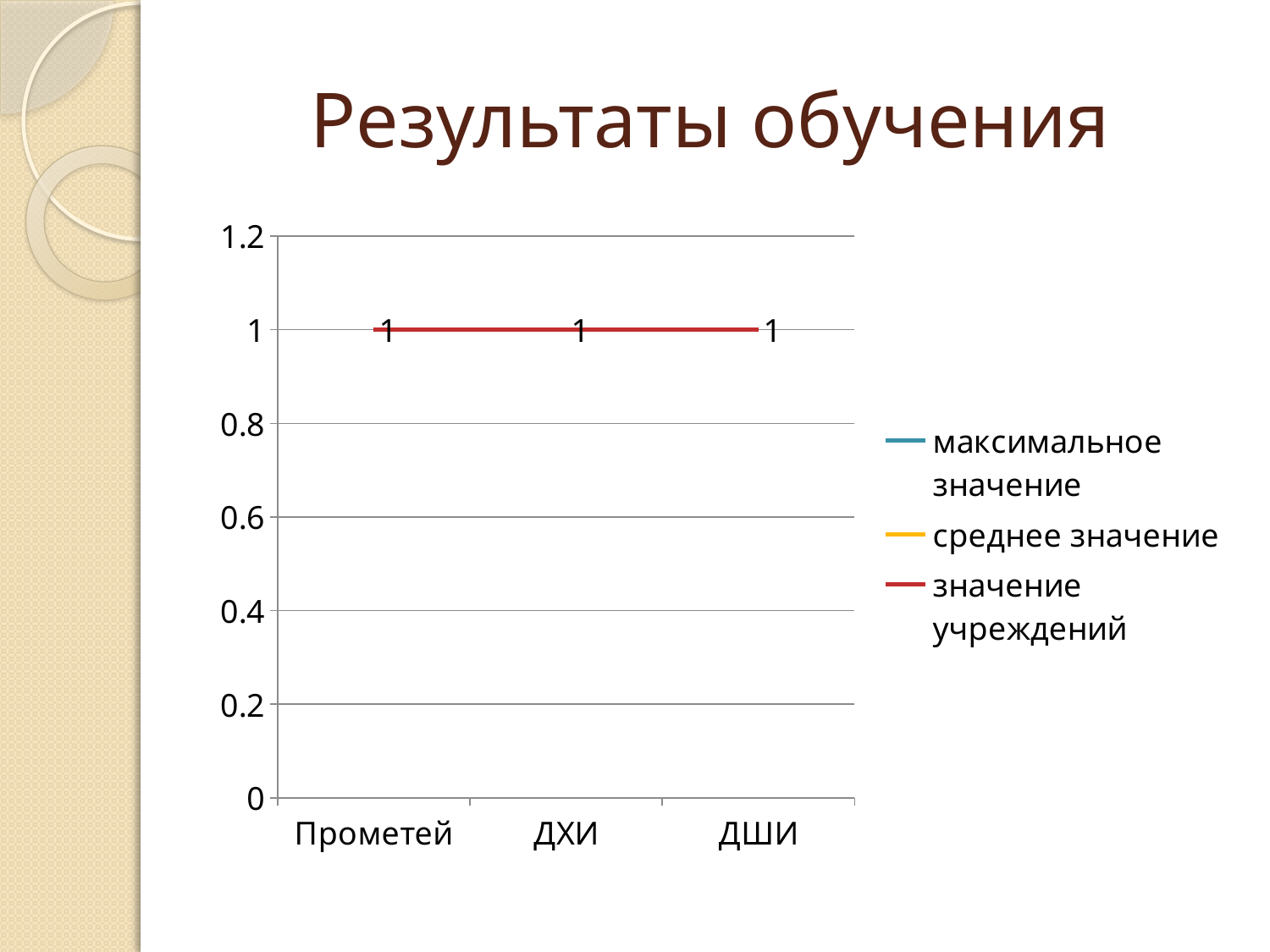
What kind of chart is shown on the slide? line chart Is the value for ДХИ greater or less than 0.8? greater What is the value for ДШИ on the red line (значение учреждений)? 1 What is the title of the slide? Результаты обучения What is the value for Прометей on the red line (значение учреждений)? 1 How many series does the legend list? 3 Do the values on the red line rise, fall, or stay flat from Прометей to ДШИ? stay flat What is the difference between the values for Прометей and ДШИ on the red line? 0 Is the value for Прометей greater or less than 1.2? less What is the value for ДХИ on the red line (значение учреждений)? 1 Which series in the legend is shown in red? значение учреждений How many categories are shown on the x axis? 3